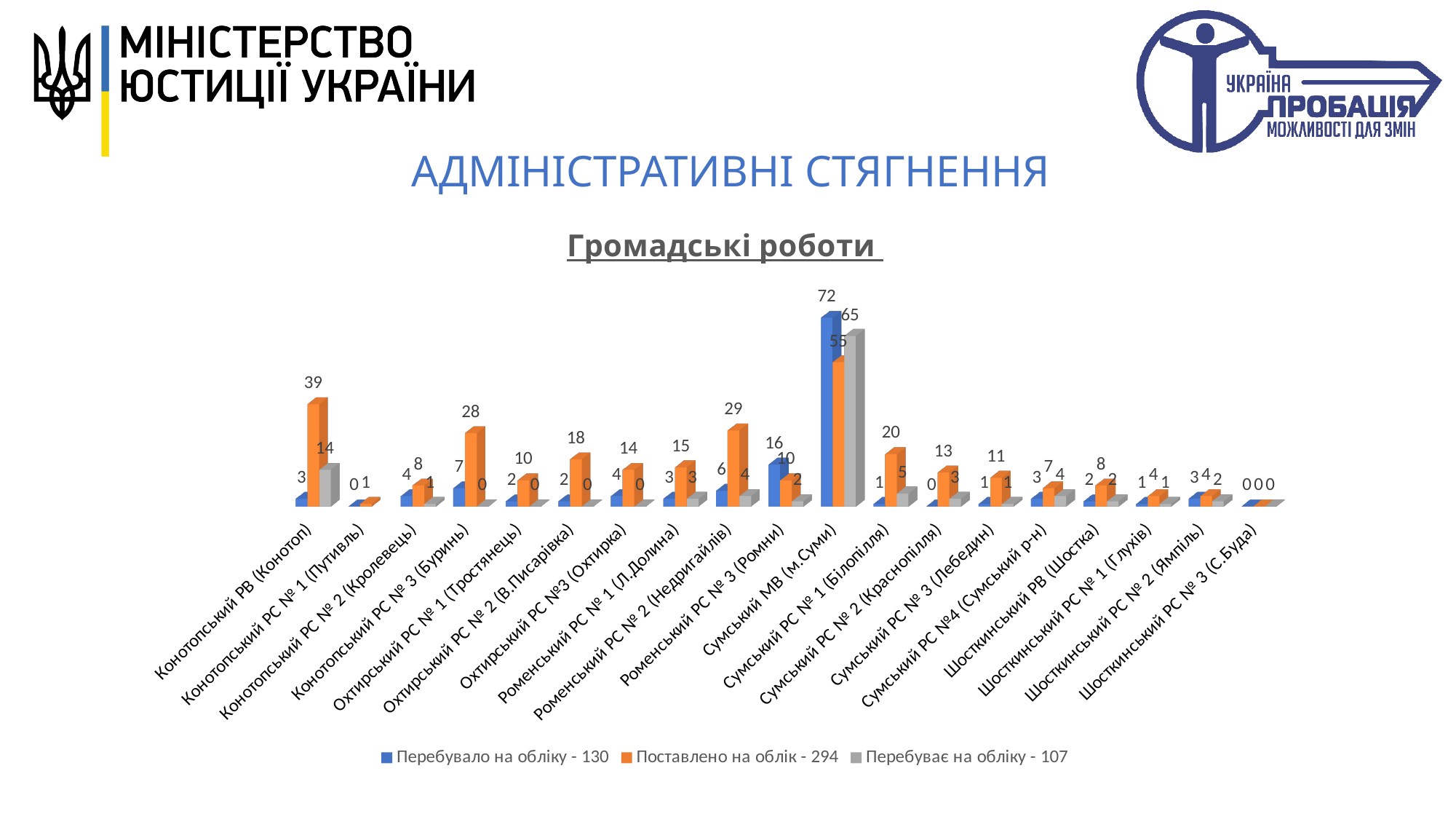
How many series does the legend of the "Громадські роботи" chart list? 3 What is the difference between the "Поставлено на облік - 294" values for Конотопський РС № 3 (Буринь) and Охтирський РС № 2 (В.Писарівка)? 10 What is the value of "Перебувало на обліку - 130" for Сумський МВ (м.Суми)? 72 What is the value of "Поставлено на облік - 294" for Роменський РС № 2 (Недригайлів)? 29 Which category has the highest value for "Поставлено на облік - 294"? Сумський МВ (м.Суми) How many categories are shown on the x axis of the "Громадські роботи" chart? 19 Which is larger for Роменський РС № 3 (Ромни): "Перебувало на обліку - 130" or "Поставлено на облік - 294"? Перебувало на обліку - 130 What type of chart is shown under the title "Громадські роботи"? bar chart What is the value of "Поставлено на облік - 294" for Конотопський РВ (Конотоп)? 39 What is the difference between the "Перебувало на обліку - 130" and "Перебуває на обліку - 107" values for Сумський МВ (м.Суми)? 7 What colour represents the series "Поставлено на облік - 294" in the chart? orange What is the value of "Перебуває на обліку - 107" for Сумський РС № 1 (Білопілля)? 5